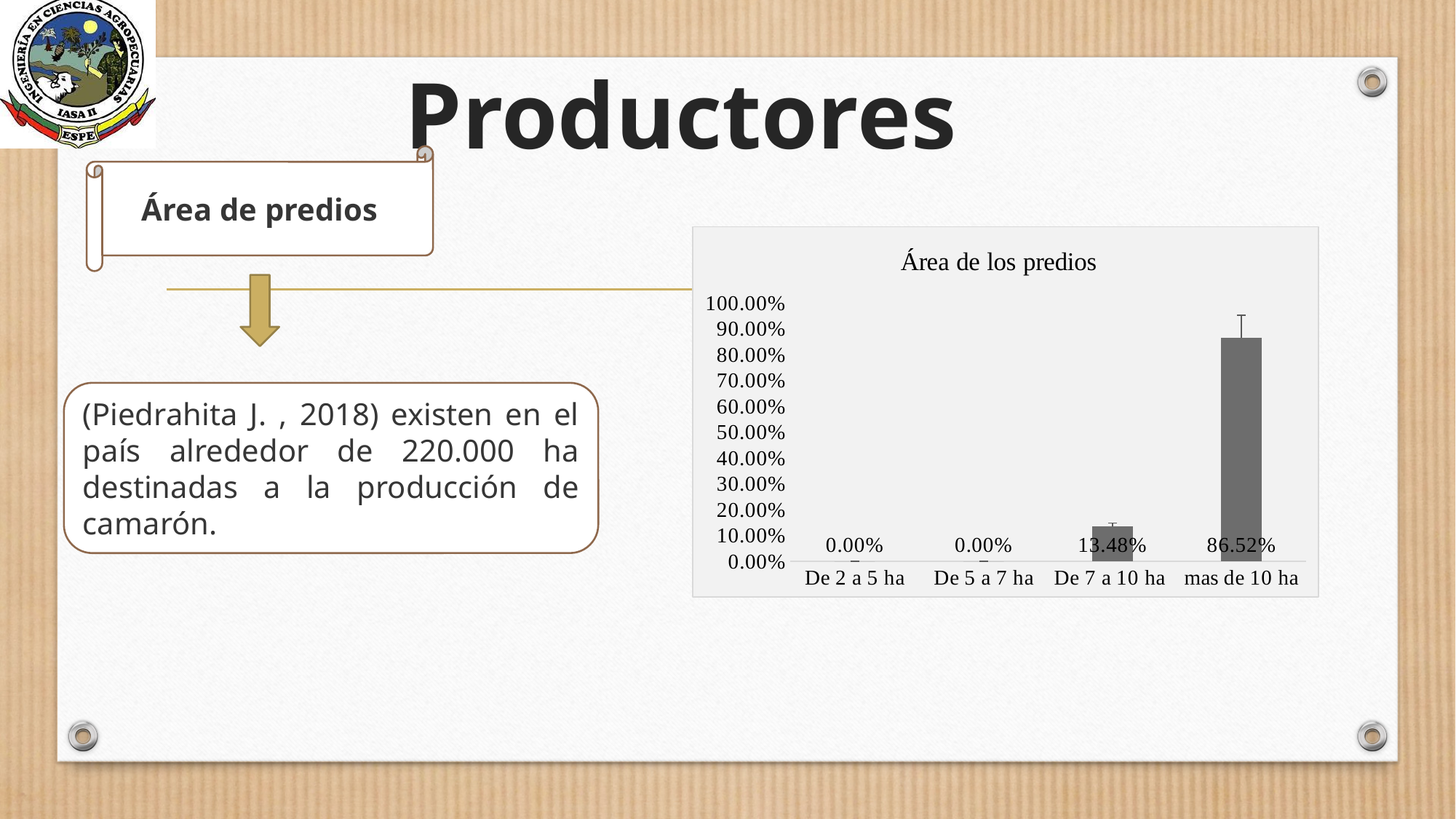
What is the difference between the values for 'mas de 10 ha' and 'De 7 a 10 ha' in the 'Área de los predios' chart? 73.04% What kind of chart is the 'Área de los predios' chart? bar chart What is the value for 'mas de 10 ha' in the 'Área de los predios' chart? 86.52% Which is larger in the 'Área de los predios' chart: the value for 'De 7 a 10 ha' or the value for 'mas de 10 ha'? mas de 10 ha What is the value for 'De 2 a 5 ha' in the 'Área de los predios' chart? 0.00% Is the value for 'De 7 a 10 ha' in the 'Área de los predios' chart greater or less than 20.00%? less What is the value for 'De 7 a 10 ha' in the 'Área de los predios' chart? 13.48% What is the value for 'De 5 a 7 ha' in the 'Área de los predios' chart? 0.00% What is the title of the chart on the slide? Área de los predios How many categories are shown on the x axis of the 'Área de los predios' chart? 4 Is the value for 'mas de 10 ha' in the 'Área de los predios' chart greater or less than 80.00%? greater Which category has the highest value in the 'Área de los predios' chart? mas de 10 ha